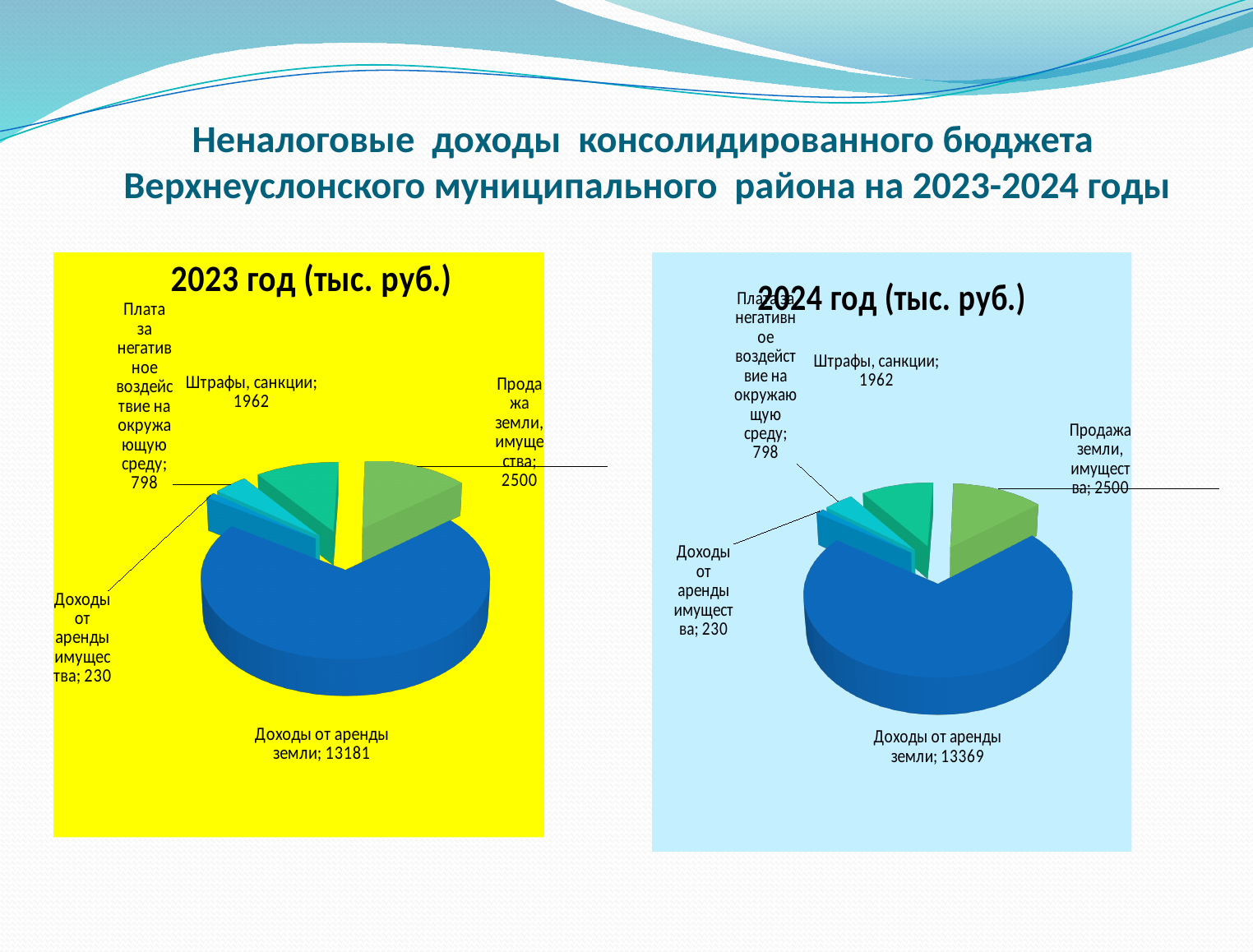
In the 2023 год (тыс. руб.) chart, what is the difference between Продажа земли, имущества and Штрафы, санкции? 538 In the 2024 год (тыс. руб.) chart, what is the value for Плата за негативное воздействие на окружающую среду? 798 What is the total of all categories in the 2024 год (тыс. руб.) chart? 18859 In the 2023 год (тыс. руб.) chart, what is the value for Доходы от аренды земли? 13181 In the 2023 год (тыс. руб.) chart, which category has the smallest value? Доходы от аренды имущества How many categories are shown in the 2023 год (тыс. руб.) chart? 5 What type of chart is the 2024 год (тыс. руб.) chart? Pie chart In the 2024 год (тыс. руб.) chart, which is larger: Штрафы, санкции or Плата за негативное воздействие на окружающую среду? Штрафы, санкции In the 2024 год (тыс. руб.) chart, which category has the largest value? Доходы от аренды земли In the 2024 год (тыс. руб.) chart, what is the value for Доходы от аренды земли? 13369 What is the difference between the Доходы от аренды земли values in the 2024 chart and the 2023 chart? 188 In the 2023 год (тыс. руб.) chart, what is the value for Продажа земли, имущества? 2500